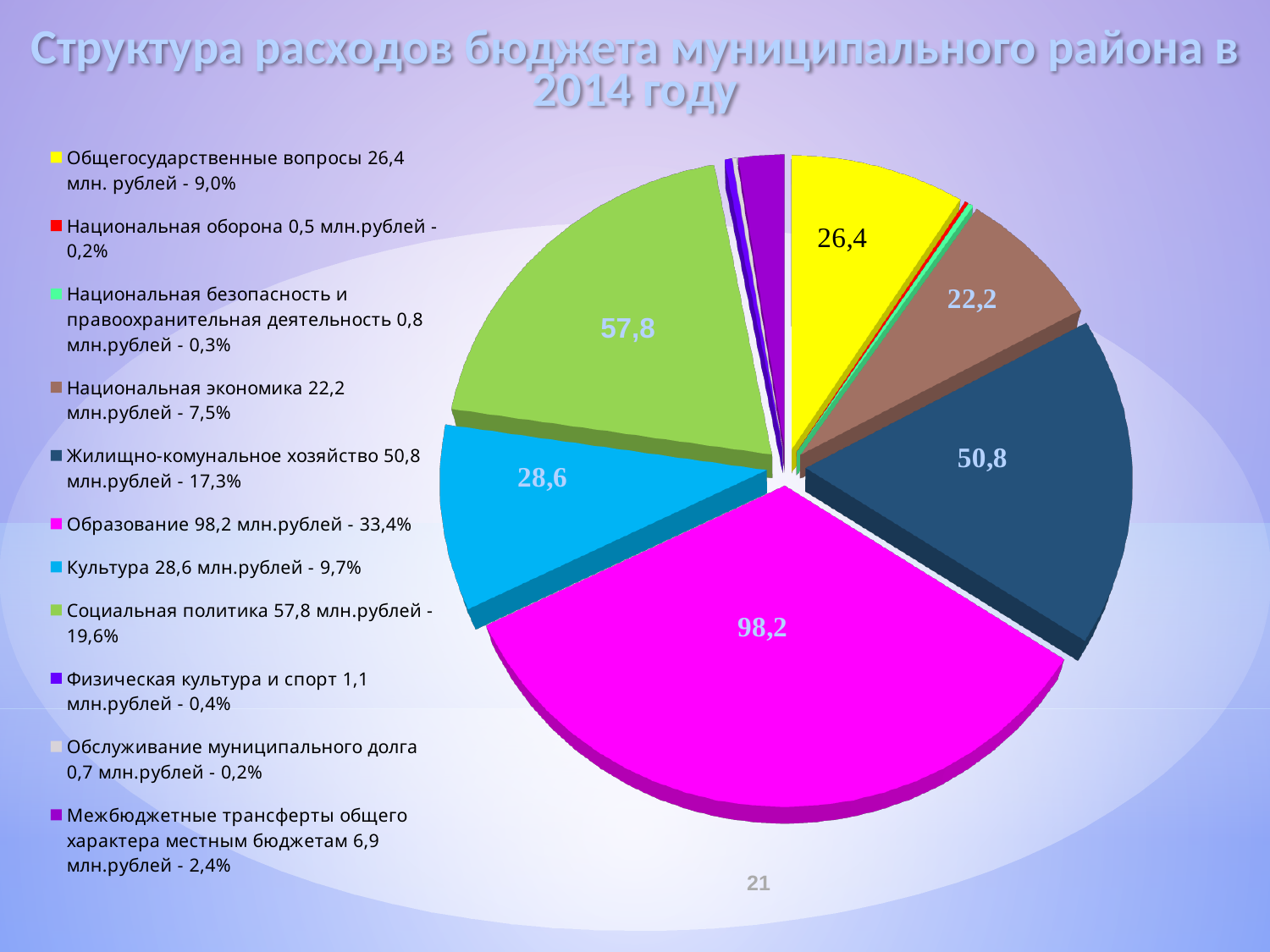
What is the value for Образование in the pie chart? 98,2 млн.рублей What is the title of the chart on the slide? Структура расходов бюджета муниципального района в 2014 году What is the difference between the values for Социальная политика and Культура? 29,2 млн.рублей Which category has the largest slice of the pie chart? Образование What share of the pie does Жилищно-коммунальное хозяйство account for? 17,3% Which is larger, the value for Культура or the value for Общегосударственные вопросы? Культура What share of the pie does Социальная политика account for? 19,6% Which category has the smallest value in the pie chart? Национальная оборона What kind of chart is shown on the slide? Pie chart What is the difference between the values for Образование and Жилищно-коммунальное хозяйство? 47,4 млн.рублей How many categories does the legend of the pie chart list? 11 What is the value for Национальная экономика in the pie chart? 22,2 млн.рублей